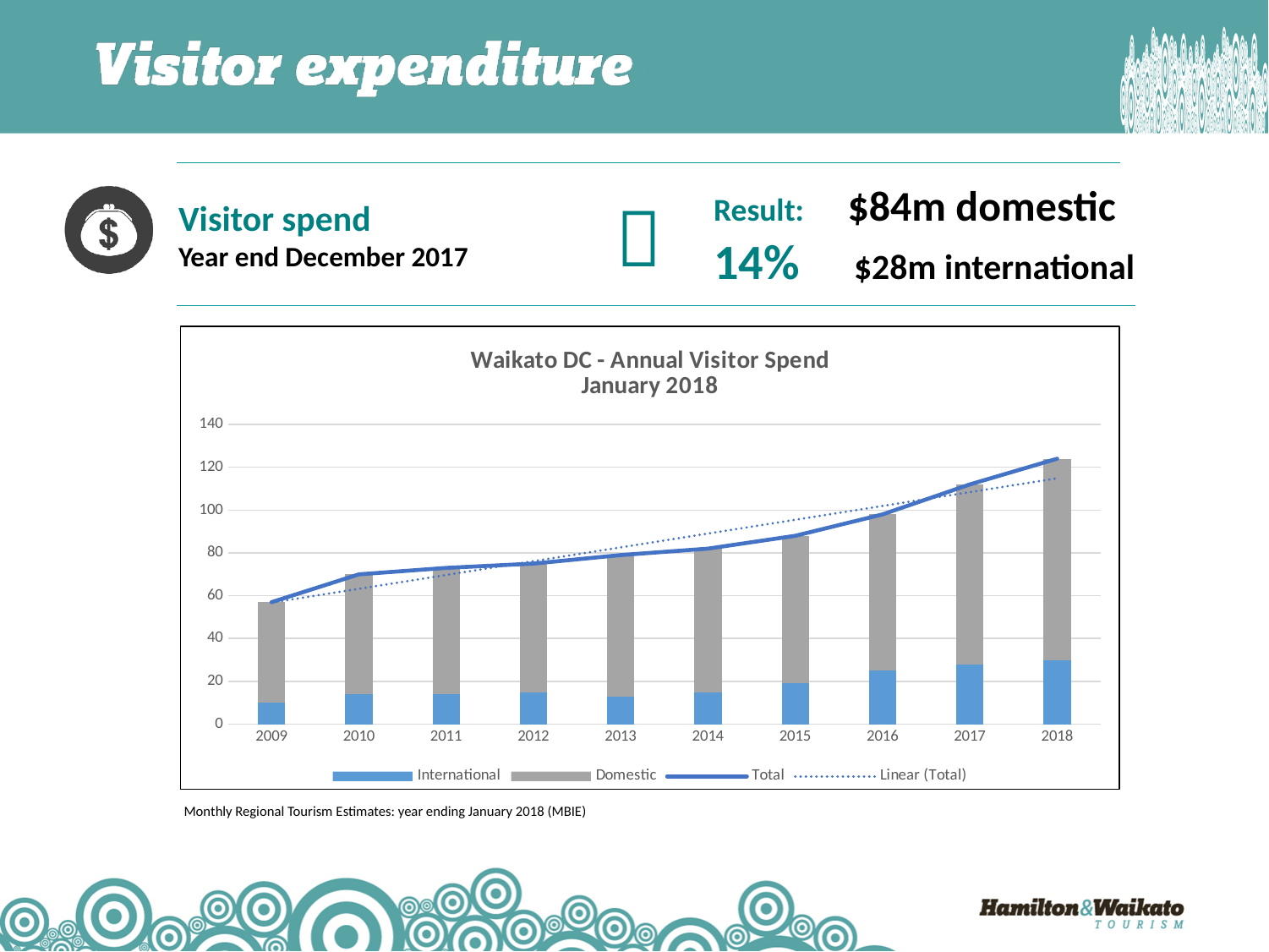
Is the International value for 2009 greater or less than 20? less Is the International value for 2018 greater or less than 20? greater Does the total visitor spend rise or fall from 2009 to 2018? rise In 2018, which is larger, the Domestic or the International spend? Domestic What is the title of the chart? Waikato DC - Annual Visitor Spend January 2018 Is the total visitor spend for 2017 greater or less than 100? greater How many years are shown on the x axis of the chart? 10 Which year has the lowest total visitor spend in the chart? 2009 How many entries does the chart legend list? 4 Which year has the highest total visitor spend in the chart? 2018 What kind of chart is shown on the slide? combination bar and line chart